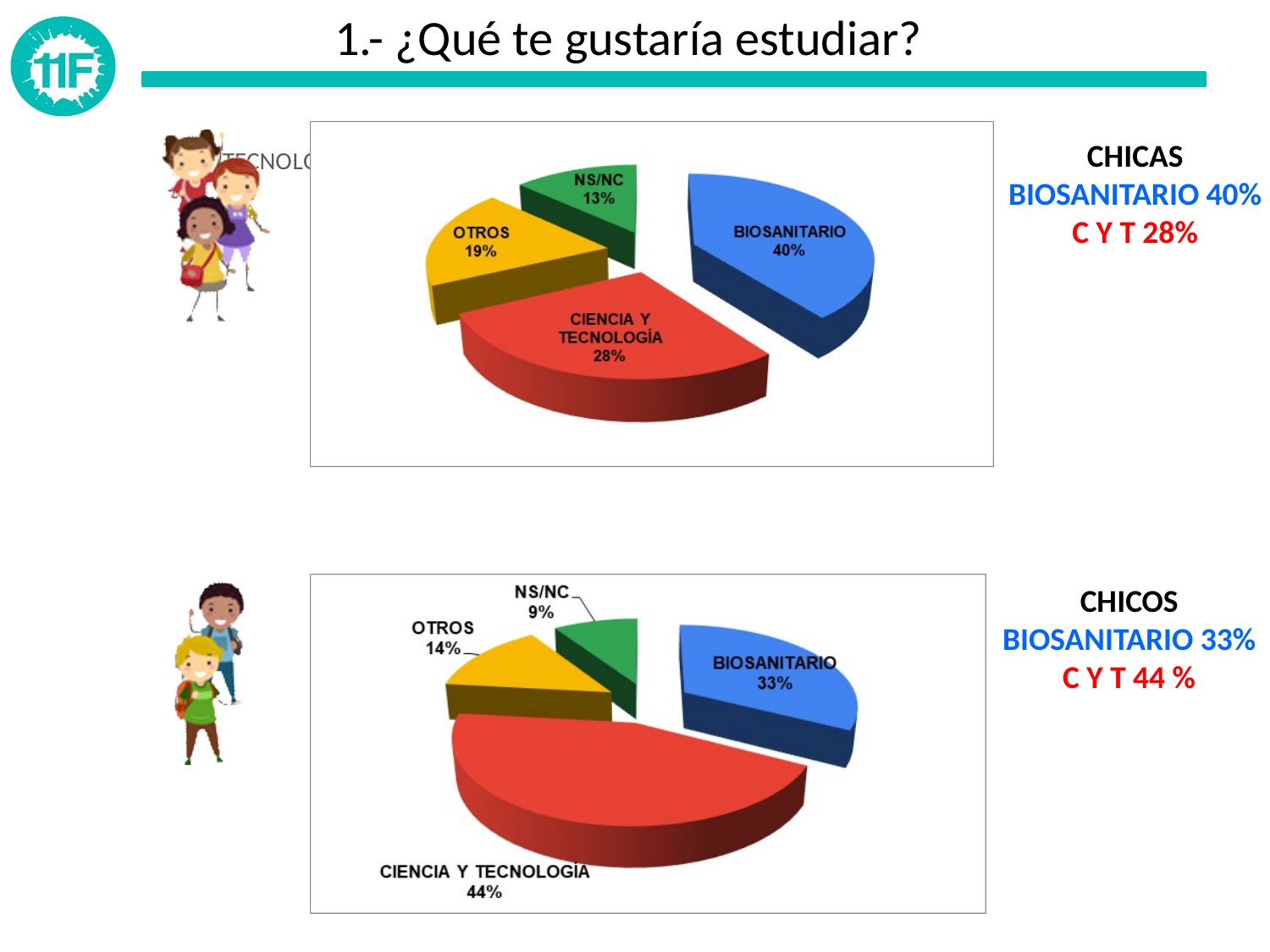
In the bottom pie chart (CHICOS), what percentage is shown for NS/NC? 9% In the bottom pie chart (CHICOS), which category has the smallest share? NS/NC In the top pie chart (CHICAS), which category has the largest share? BIOSANITARIO In the top pie chart (CHICAS), what is the difference in percentage points between BIOSANITARIO and CIENCIA Y TECNOLOGÍA? 12 In the top pie chart (CHICAS), what percentage is shown for OTROS? 19% In the bottom pie chart (CHICOS), which is larger, BIOSANITARIO or OTROS? BIOSANITARIO What type of chart is the bottom chart (CHICOS)? Pie chart In the bottom pie chart (CHICOS), which category has the largest share? CIENCIA Y TECNOLOGÍA How many slices does the top pie chart (CHICAS) have? 4 In the bottom pie chart (CHICOS), what percentage is shown for CIENCIA Y TECNOLOGÍA? 44% In the top pie chart (CHICAS), what percentage is shown for BIOSANITARIO? 40% In the top pie chart (CHICAS), what percentage is shown for CIENCIA Y TECNOLOGÍA? 28%